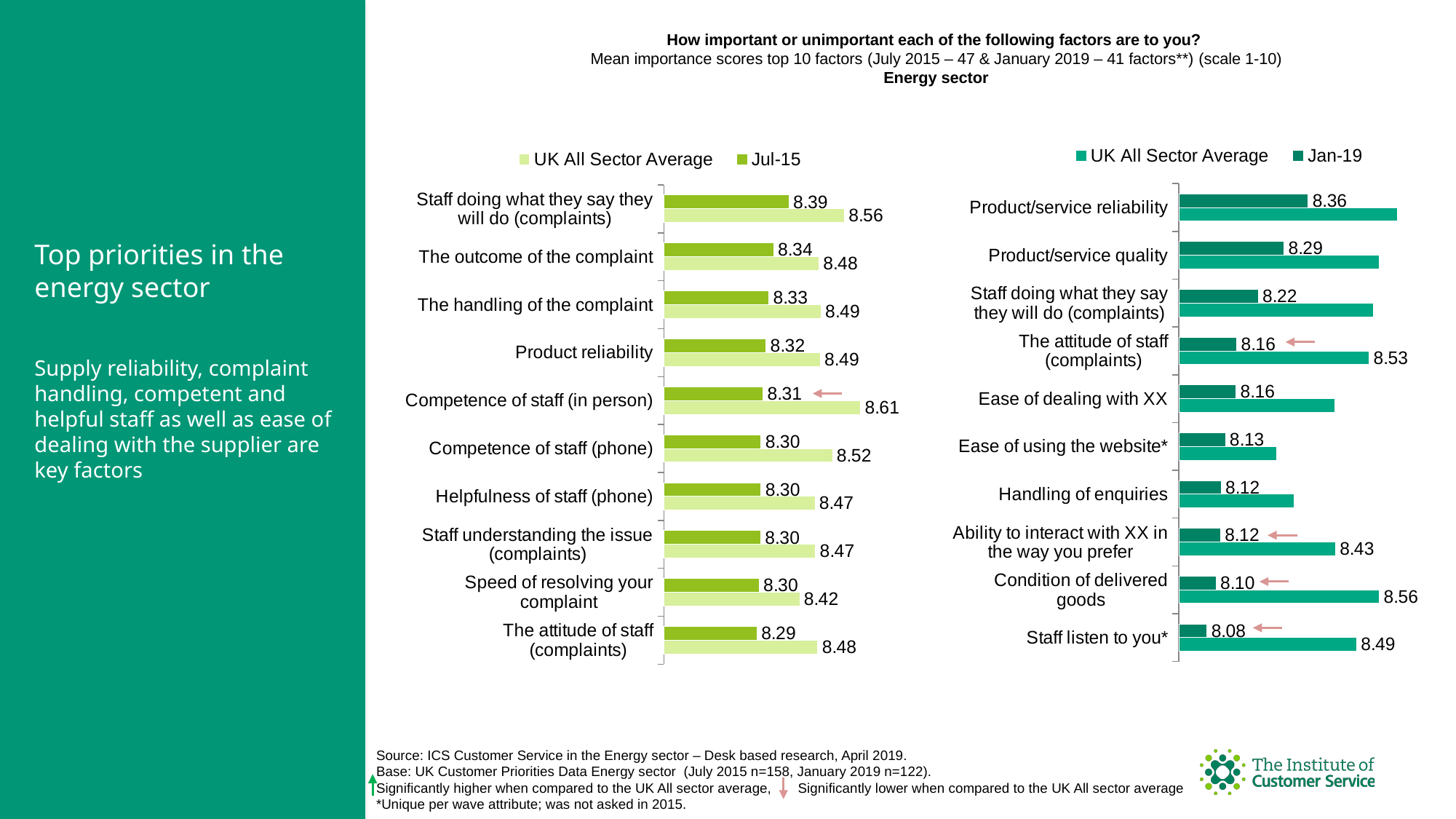
In the left chart (Jul-15), which factor has the highest Jul-15 score? Staff doing what they say they will do (complaints) In the right chart (Jan-19), which has a higher Jan-19 score: 'Product/service quality' or 'Ease of using the website*'? Product/service quality What are the two legend entries of the right chart? UK All Sector Average and Jan-19 How many factors are listed in the left chart (Jul-15)? 10 In the right chart (Jan-19), what is the difference between the UK All Sector Average and the Jan-19 score for 'Condition of delivered goods'? 0.46 In the right chart (Jan-19), what is the Jan-19 value for 'Product/service reliability'? 8.36 In the left chart (Jul-15), what is the Jul-15 value for 'Staff doing what they say they will do (complaints)'? 8.39 In the left chart (Jul-15), what is the difference between the UK All Sector Average and the Jul-15 score for 'Competence of staff (in person)'? 0.30 In the right chart (Jan-19), which factor has the lowest Jan-19 score? Staff listen to you* In the left chart (Jul-15), what is the UK All Sector Average value for 'Speed of resolving your complaint'? 8.42 How many series does the legend of the right chart (Jan-19) list? 2 What type of chart is the left chart (Jul-15)? Bar chart